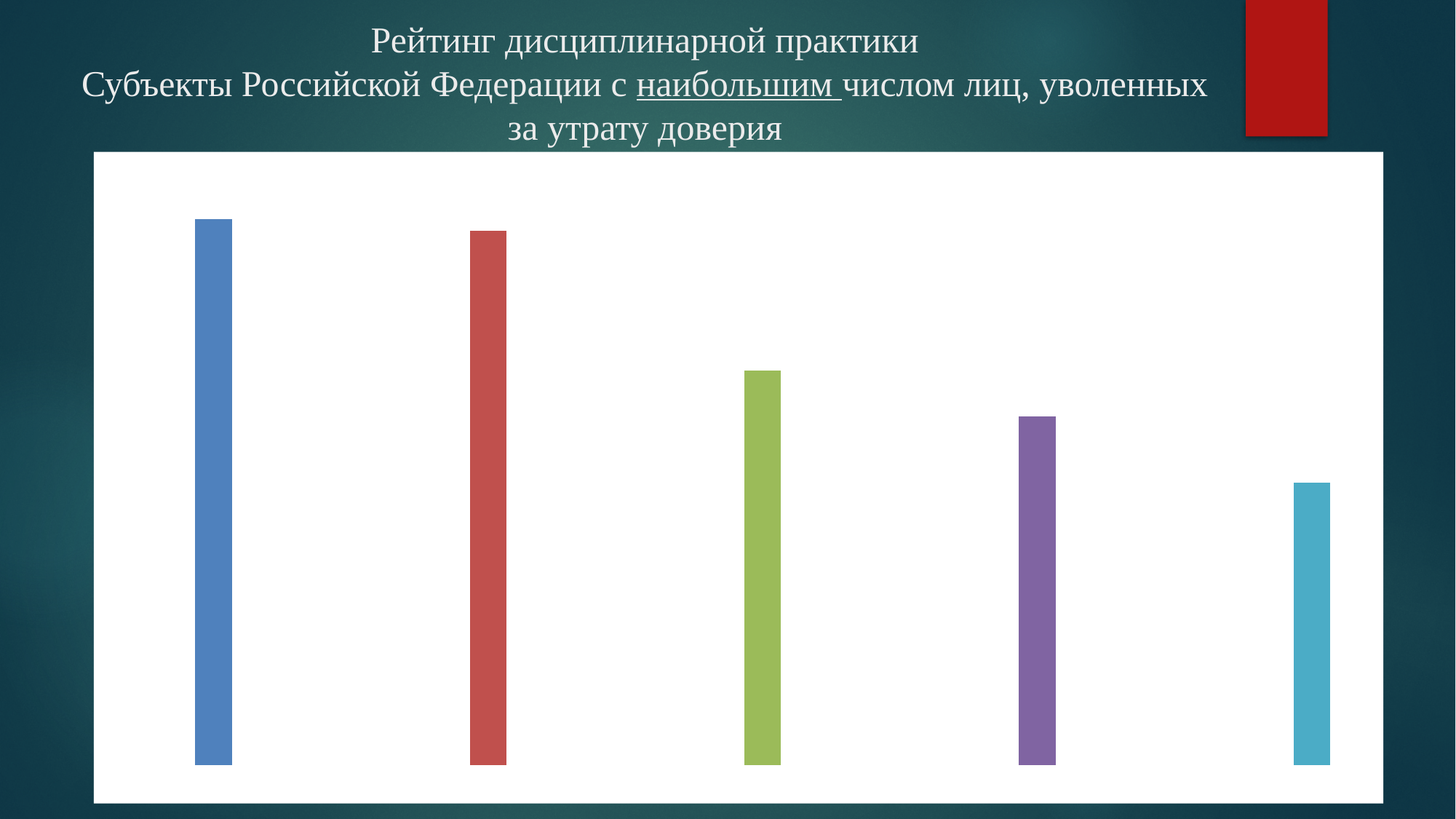
Which is taller, the red bar or the green bar? the red bar Which is taller, the green bar or the purple bar? the green bar Do the bar values rise or fall from left to right across the chart? fall What kind of chart is shown on the slide? bar chart Does the chart display a legend? No Which bar is the shortest in the chart? the rightmost (teal) bar How many bars does the chart contain? 5 What colour is the second bar from the left? red Which is taller, the purple bar or the teal bar? the purple bar Which bar is the tallest in the chart? the leftmost (blue) bar